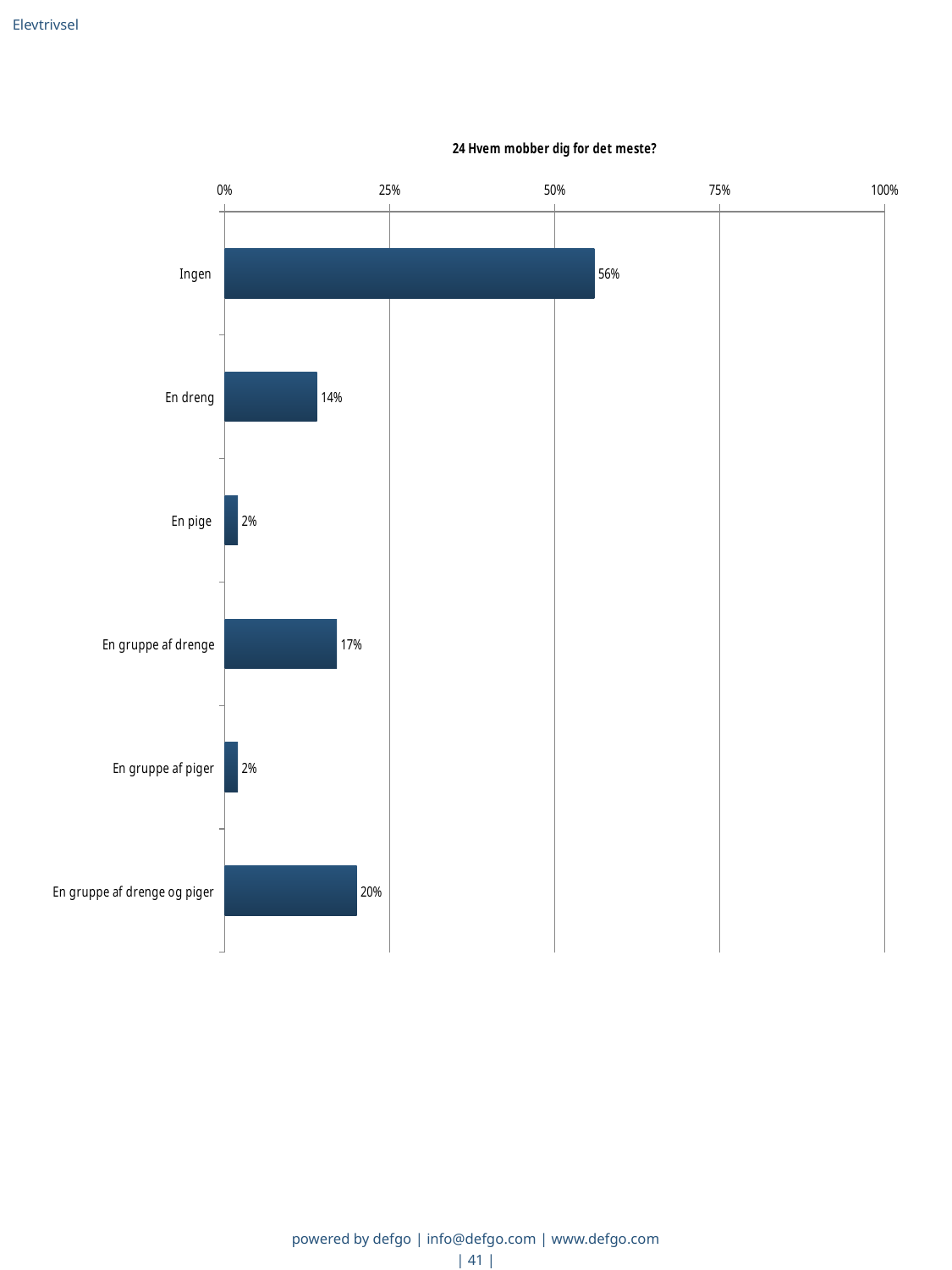
How many categories are shown in the chart? 6 Is the value for "En gruppe af drenge og piger" greater or less than 25%? less What is the value for "En gruppe af drenge og piger"? 20% Is the value for "Ingen" greater or less than 50%? greater Which category has the highest value? Ingen What is the value for "En dreng"? 14% What is the value for "Ingen"? 56% What is the difference between the values for "Ingen" and "En gruppe af drenge og piger"? 36% What is the title of the chart? 24 Hvem mobber dig for det meste? Which is larger, the value for "En gruppe af drenge" or the value for "En dreng"? En gruppe af drenge What kind of chart is shown? Bar chart What is the difference between the values for "En gruppe af drenge" and "En pige"? 15%